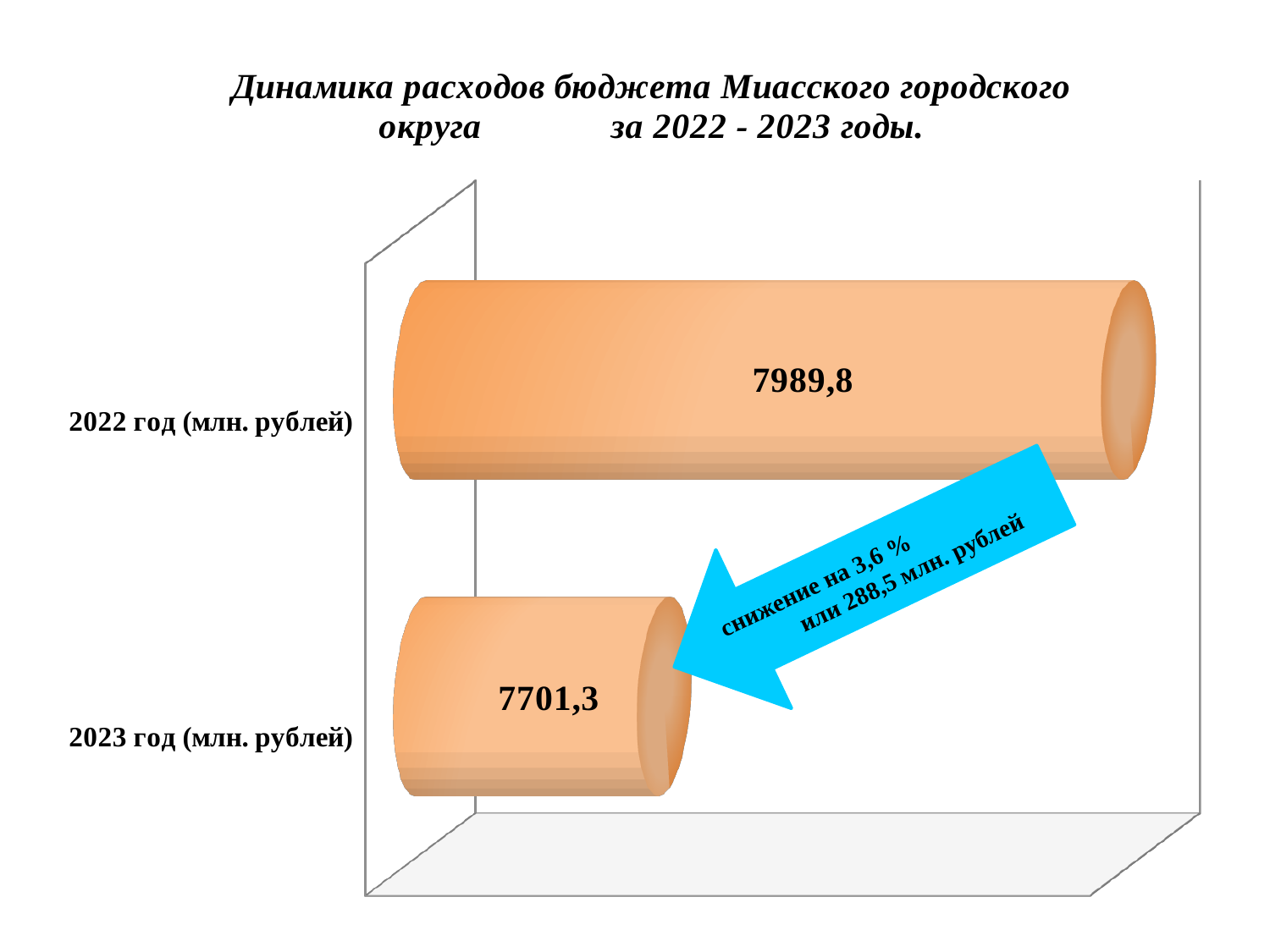
By what percentage did expenditures decrease according to the arrow annotation? 3,6 % What is the title of the chart? Динамика расходов бюджета Миасского городского округа за 2022 - 2023 годы. Do the expenditure values rise or fall from 2022 to 2023? fall Which year has the higher budget expenditure value? 2022 год What is the difference between the 2022 and 2023 values? 288,5 What is the value for 2023 год (млн. рублей)? 7701,3 Is the value for 2022 год larger or smaller than the value for 2023 год? larger How many bars (categories) are shown in the chart? 2 What kind of chart is shown on the slide? bar chart Which year has the lower budget expenditure value? 2023 год What is the value for 2022 год (млн. рублей)? 7989,8